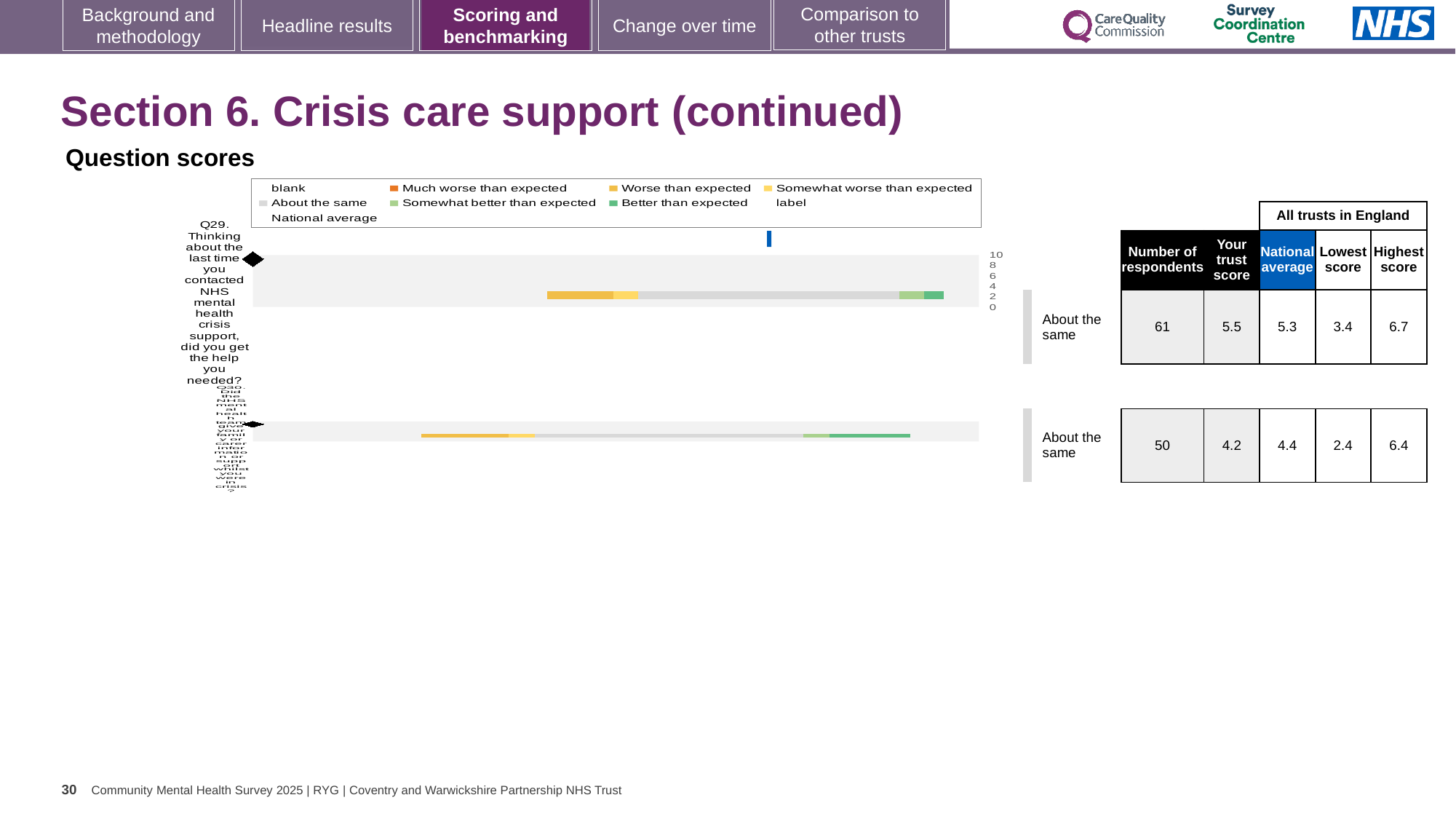
What is the trust score for Q29 (Thinking about the last time you contacted NHS mental health crisis support, did you get the help you needed?)? 5.5 What is the trust score for Q30? 4.2 How many questions (categories) are plotted in the question scores chart? 2 What is the difference between the highest score and the lowest score for Q29 across all trusts in England? 3.3 Which legend entry is shown in orange? Much worse than expected Which question has the higher trust score, Q29 or Q30? Q29 What is the national average for Q29? 5.3 What is the highest score across all trusts in England for Q30? 6.4 How many respondents answered Q30? 50 What benchmark category is shown for Q29? About the same What kind of chart is used to show the question scores on this slide? bar chart What is the difference between the national average and the trust score for Q30? 0.2